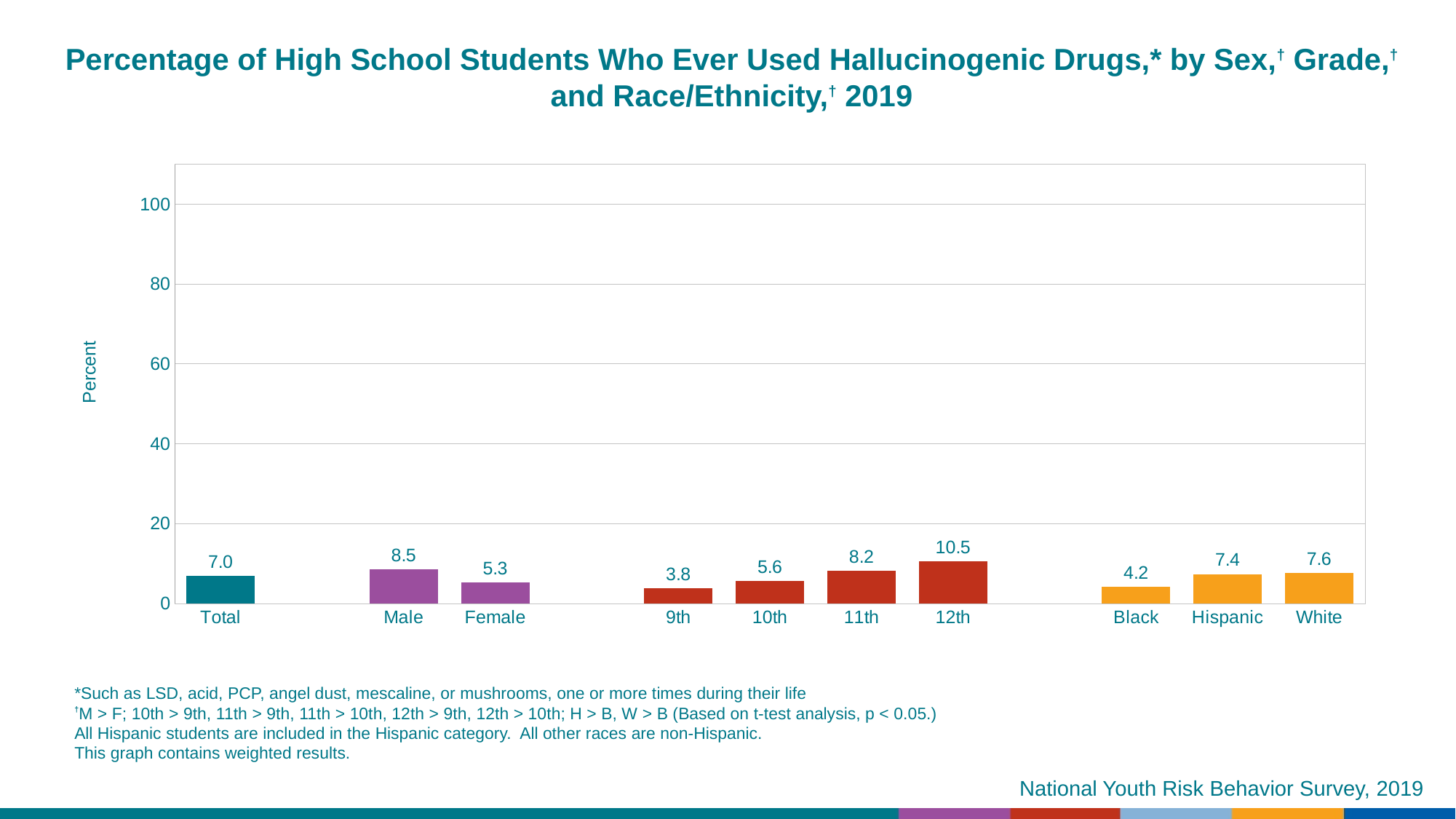
What is the value for 12th grade? 10.5 Which is larger, the value for Hispanic or the value for Black? Hispanic What is the difference between the 12th grade and 9th grade values? 6.7 How many categories are shown on the x axis? 10 Which category has the highest value? 12th What is the value for Black students? 4.2 What is the value for Total? 7.0 Which category has the lowest value? 9th What percentage of Male students ever used hallucinogenic drugs? 8.5 Do the values rise or fall from 9th grade to 12th grade? rise What is the difference between the Male and Female values? 3.2 What kind of chart is this? bar chart